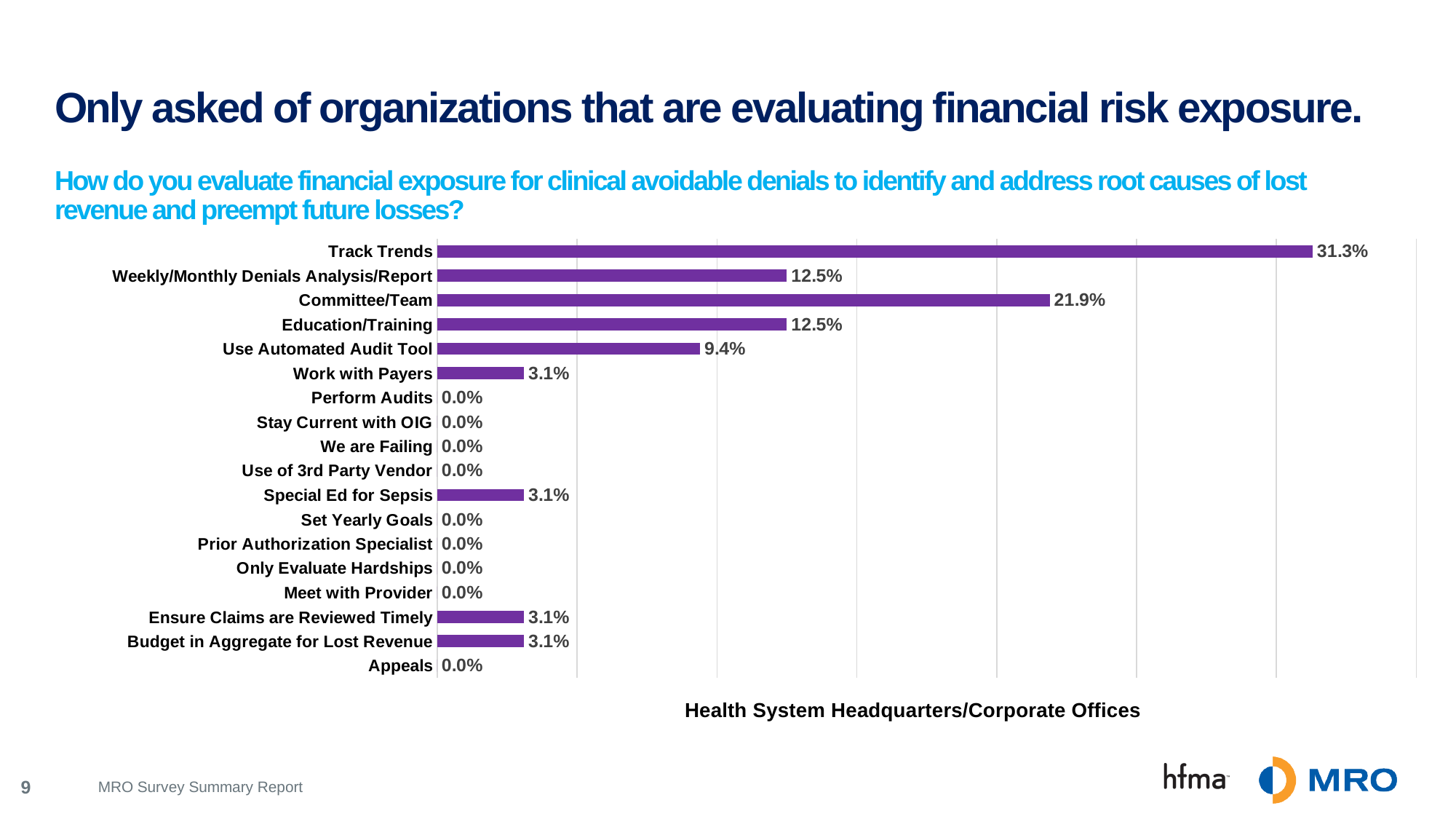
Which category has the highest value? Track Trends Which is larger, Committee/Team or Education/Training? Committee/Team What is the label shown beneath the chart? Health System Headquarters/Corporate Offices What kind of chart is shown on the slide? Bar chart What is the value for Use Automated Audit Tool? 9.4% What is the value for Work with Payers? 3.1% What is the value for Education/Training? 12.5% What is the value for Committee/Team? 21.9% How many categories are shown in the chart? 18 What is the value for Track Trends? 31.3% What is the difference between Track Trends and Committee/Team? 9.4% What is the difference between Weekly/Monthly Denials Analysis/Report and Use Automated Audit Tool? 3.1%